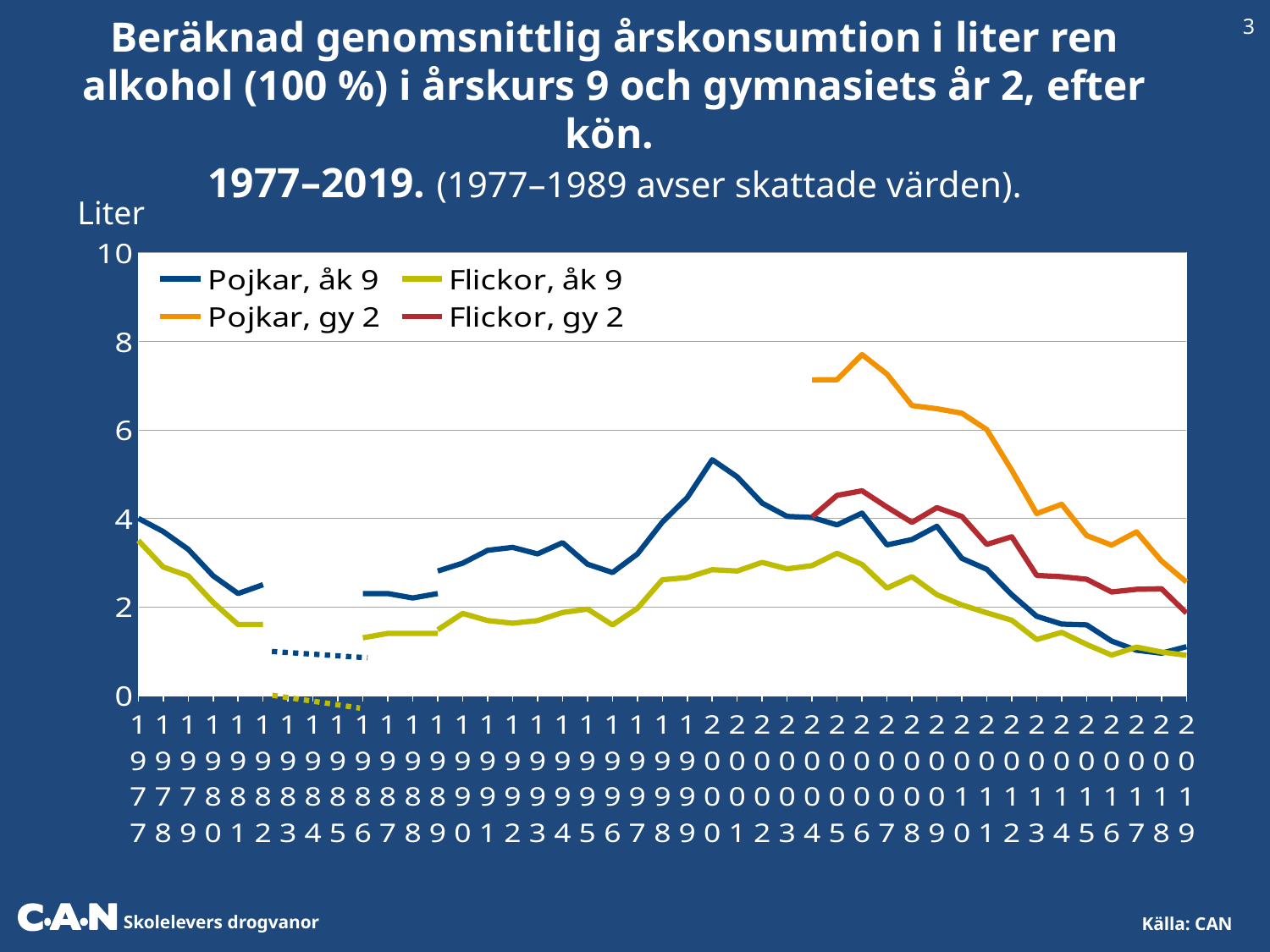
What is the label on the vertical axis? Liter Is the value for Pojkar, gy 2 in 2006 greater or less than 6? greater Does the Pojkar, gy 2 line rise or fall from 2006 to 2019? fall Which series are listed in the legend? Pojkar, åk 9; Pojkar, gy 2; Flickor, åk 9; Flickor, gy 2 What is the first year and the last year shown on the x axis? 1977 and 2019 Is the value for Flickor, åk 9 in 2019 greater or less than 2? less In 2006, which is larger: Pojkar, gy 2 or Flickor, gy 2? Pojkar, gy 2 How many series does the legend list? 4 What kind of chart is shown on the slide? line chart Which series reaches the highest value anywhere on the chart? Pojkar, gy 2 Is the value for Pojkar, åk 9 in 2000 greater or less than 4? greater